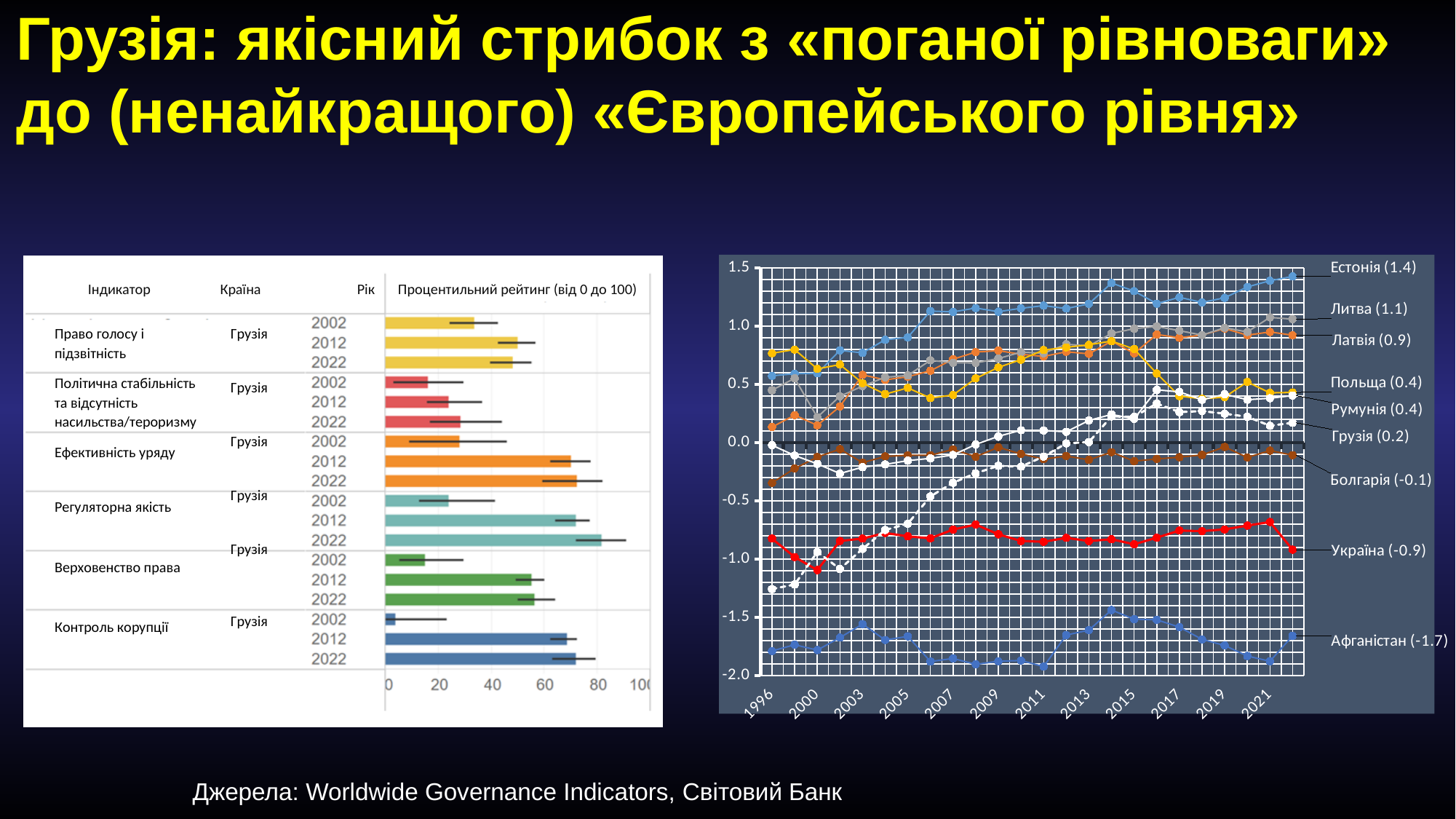
In the left-hand bar chart, do the values for Контроль корупції rise or fall from 2002 to 2022? rise In the right-hand line chart, what is the difference between the labelled values for Естонія and Грузія? 1.2 In the right-hand line chart, what value is shown in the label for Україна? -0.9 How many countries are labelled on the right-hand line chart? 9 In the right-hand line chart, which has the larger labelled value, Литва or Латвія? Литва What kind of chart is the chart on the right side of the slide? line chart In the right-hand line chart, what value is shown in the label for Естонія? 1.4 In the right-hand line chart, what value is shown in the label for Афганістан? -1.7 What kind of chart is the chart on the left side of the slide? bar chart In the right-hand line chart, which labelled country has the lowest value? Афганістан In the right-hand line chart, which labelled country has the highest value? Естонія In the left-hand bar chart, is the 2002 value for Контроль корупції greater or less than 20? less